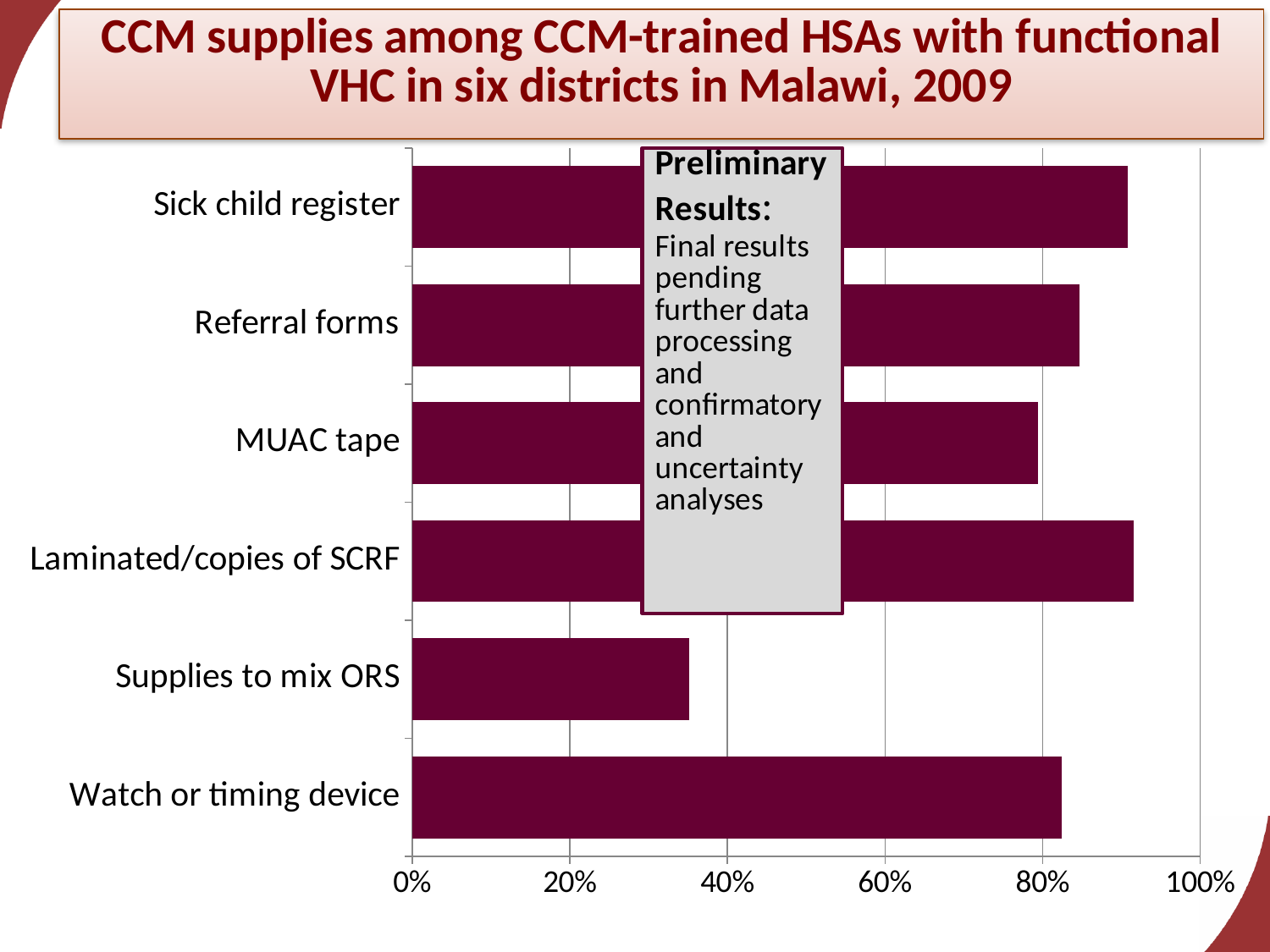
Which is larger, the value for Sick child register or the value for Supplies to mix ORS? Sick child register Which is larger, the value for Watch or timing device or the value for Supplies to mix ORS? Watch or timing device Is the value for Supplies to mix ORS greater or less than 20%? greater What kind of chart is shown on the slide? bar chart Is the value for Supplies to mix ORS greater or less than 40%? less Is the value for Laminated/copies of SCRF greater or less than 80%? greater How many categories (supply items) are shown in the chart? 6 Which supply item has the lowest value in the chart? Supplies to mix ORS What is the title of the chart on the slide? CCM supplies among CCM-trained HSAs with functional VHC in six districts in Malawi, 2009